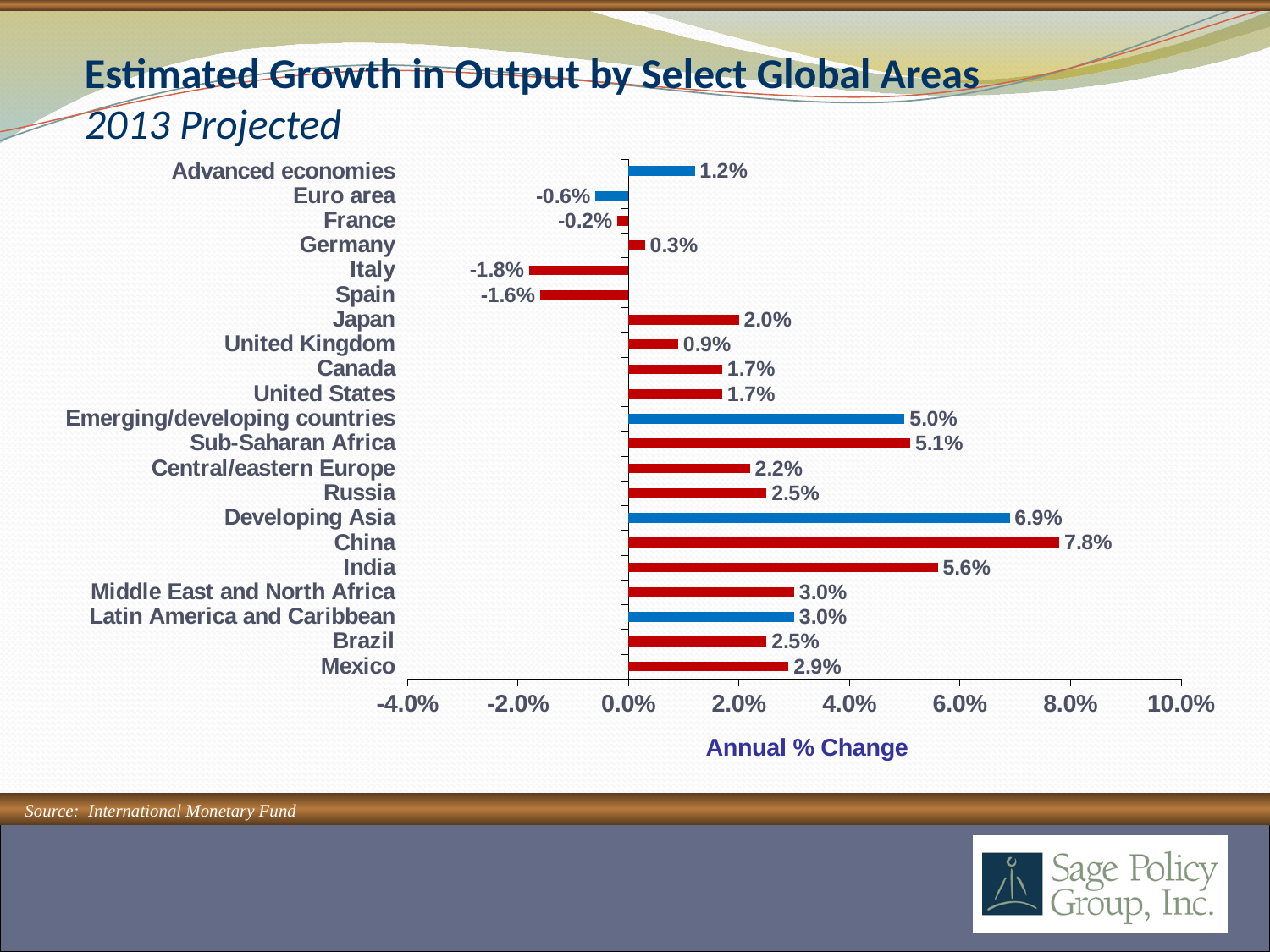
What is the difference between the projected growth for Developing Asia and Russia? 4.4% Which has the higher projected growth, Spain or Germany? Germany Which area has the highest projected growth in output for 2013? China What is the label of the horizontal axis? Annual % Change How many areas are listed on the chart? 21 What is the projected 2013 growth in output for China? 7.8% What is the projected 2013 growth in output for Italy? -1.8% What is the projected 2013 growth in output for Sub-Saharan Africa? 5.1% Which has the higher projected growth, Japan or the United Kingdom? Japan Which area has the lowest projected growth in output for 2013? Italy What type of chart is shown on the slide? Bar chart What is the difference between the projected growth for China and India? 2.2%